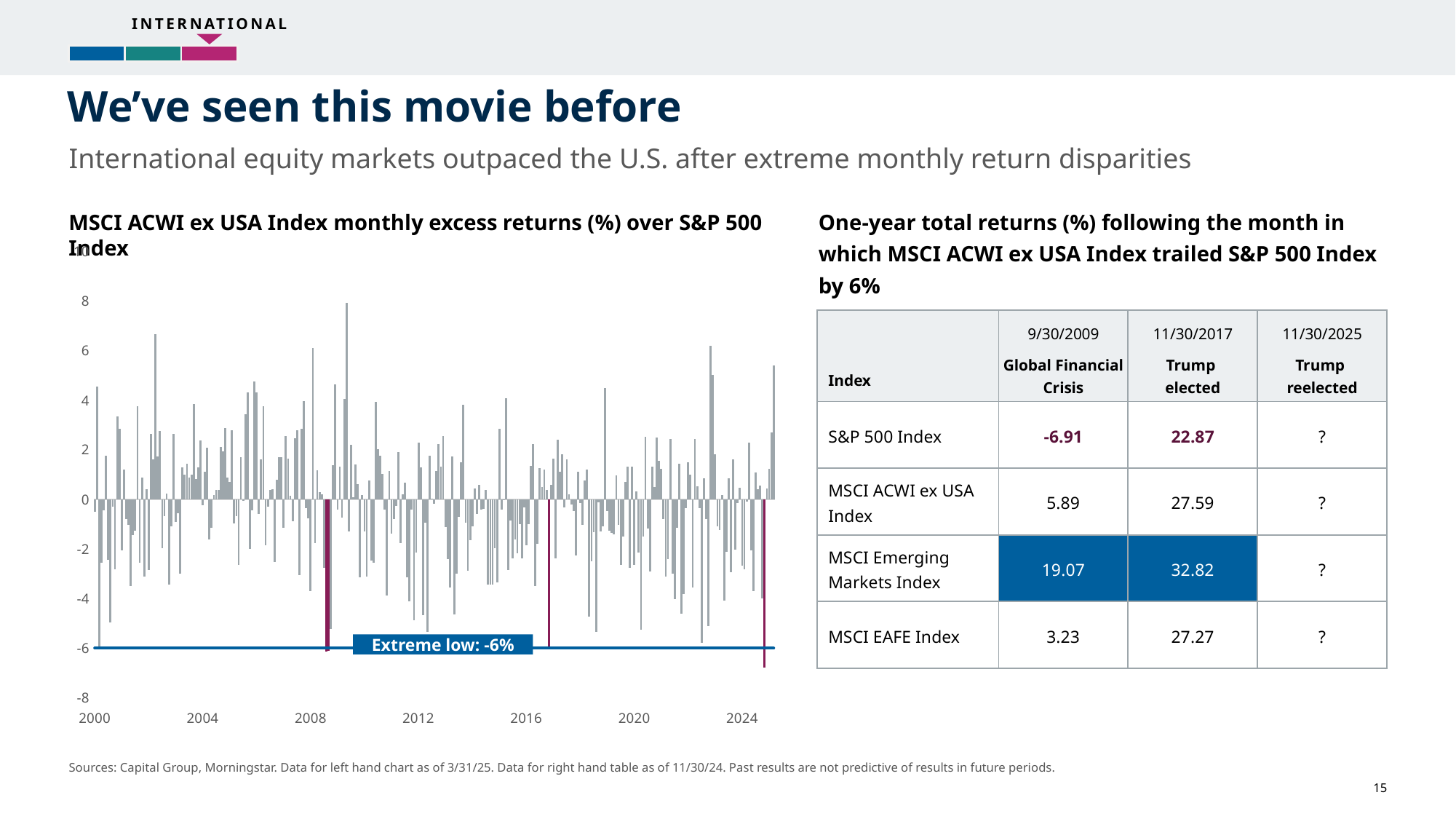
Is the lowest bar on the chart (near 2024) greater or less than -6? less What is the first year label on the x axis of the chart? 2000 How many bars on the chart are highlighted in magenta as falling below the extreme low line? 4 What is the highest value labelled on the y axis of the chart? 8 Is the tallest bar on the chart greater or less than 4? greater What kind of chart is shown on the left of the slide? bar chart What value does the horizontal blue line on the chart mark, according to its label? Extreme low: -6% What is the lowest value labelled on the y axis of the chart? -8 How many year labels are shown on the x axis of the chart? 7 Is the tallest bar on the chart greater or less than 6? greater What is the last year label on the x axis of the chart? 2024 What is the title of the chart on the left of the slide? MSCI ACWI ex USA Index monthly excess returns (%) over S&P 500 Index